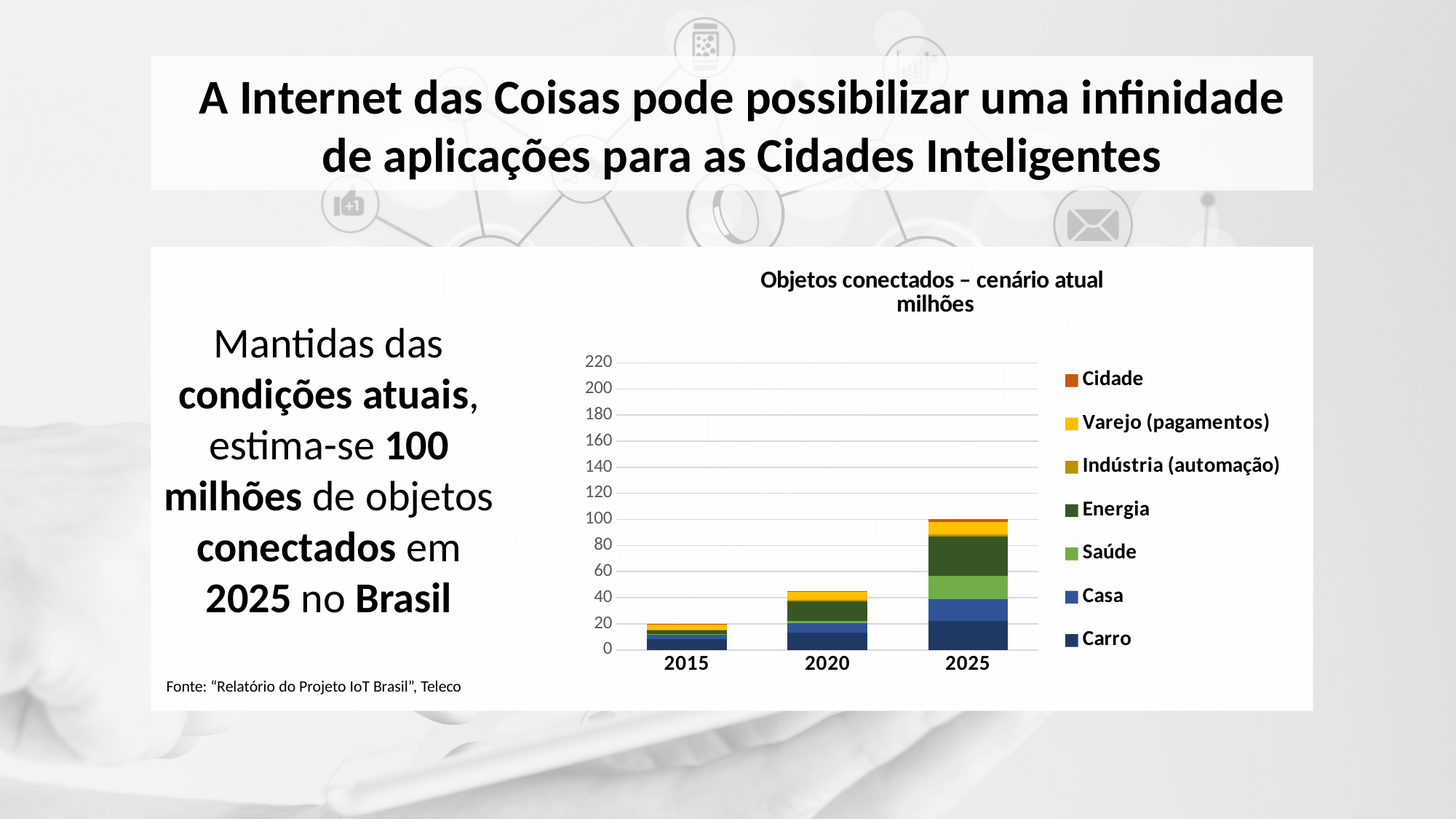
Is the total value for 2025 greater or less than 80? greater Which year has the shortest stacked bar? 2015 How many years are shown on the x axis of the chart? 3 Which year has the tallest stacked bar? 2025 Is the total value for 2020 greater or less than 60? less What kind of chart is shown on the slide? Stacked bar chart Do the total values of the stacked bars rise or fall from 2015 to 2025? Rise How many series does the chart legend list? 7 What is the title of the chart? Objetos conectados – cenário atual milhões Which series is listed at the bottom of the chart legend? Carro Is the total value for 2015 greater or less than 40? less What is the total height of the stacked bar for 2025? 100